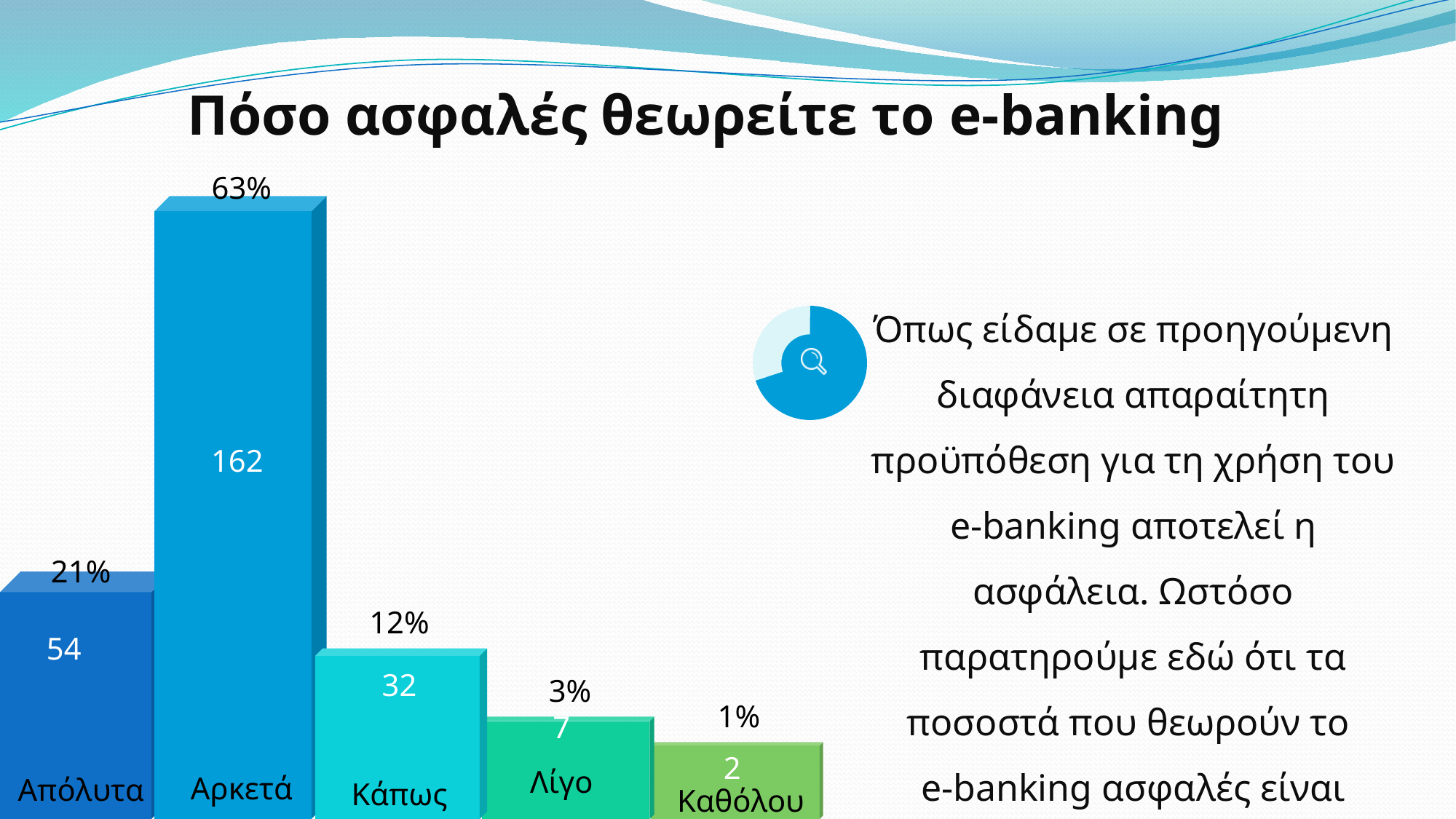
Which category has the lowest value? Καθόλου How many categories are shown in the chart? 5 What is the count shown for the Κάπως bar? 32 What percentage is shown above the Απόλυτα bar? 21% Which category has the highest value? Αρκετά Which is larger, the value for Κάπως or the value for Λίγο? Κάπως What is the count shown for the Αρκετά bar? 162 What kind of chart is shown on the slide? Bar chart What is the count shown for the Καθόλου bar? 2 What percentage is shown above the Λίγο bar? 3% What is the title of the slide containing the chart? Πόσο ασφαλές θεωρείτε το e-banking What is the difference between the counts for Αρκετά and Απόλυτα? 108